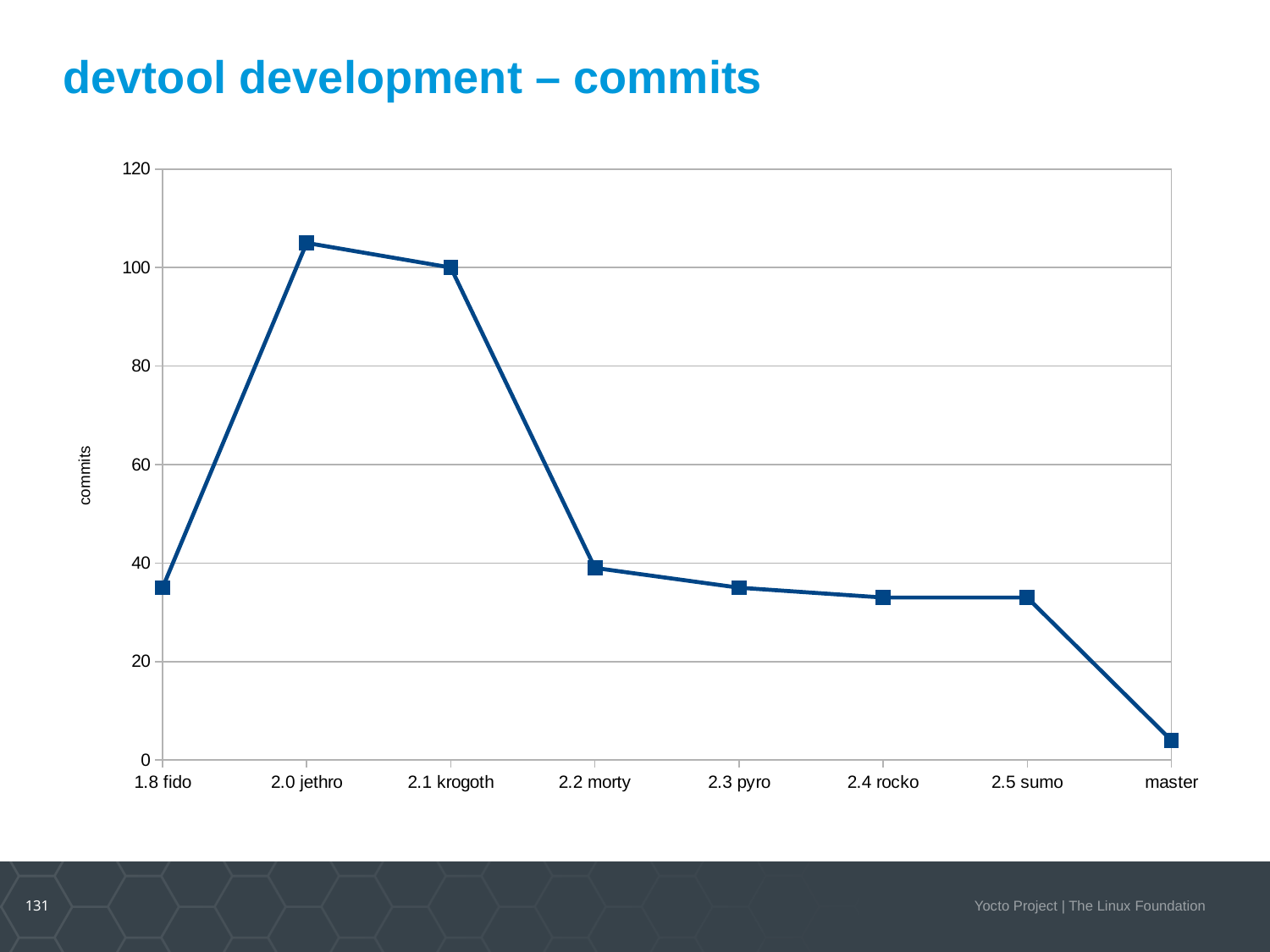
How many commits are shown for 2.1 krogoth? 100 Do the commit values rise or fall from 2.1 krogoth to master? fall How many release points are plotted on the x axis? 8 What is the title of the chart on the slide? devtool development – commits Which release has the highest number of commits? 2.0 jethro What kind of chart is shown on the slide? line chart Is the value for 2.0 jethro greater or less than 100? greater Which has more commits, 2.0 jethro or 2.2 morty? 2.0 jethro Which release has the lowest number of commits? master Is the value for master greater or less than 20? less Is the value for 1.8 fido greater or less than 40? less What is the label on the vertical axis of the chart? commits